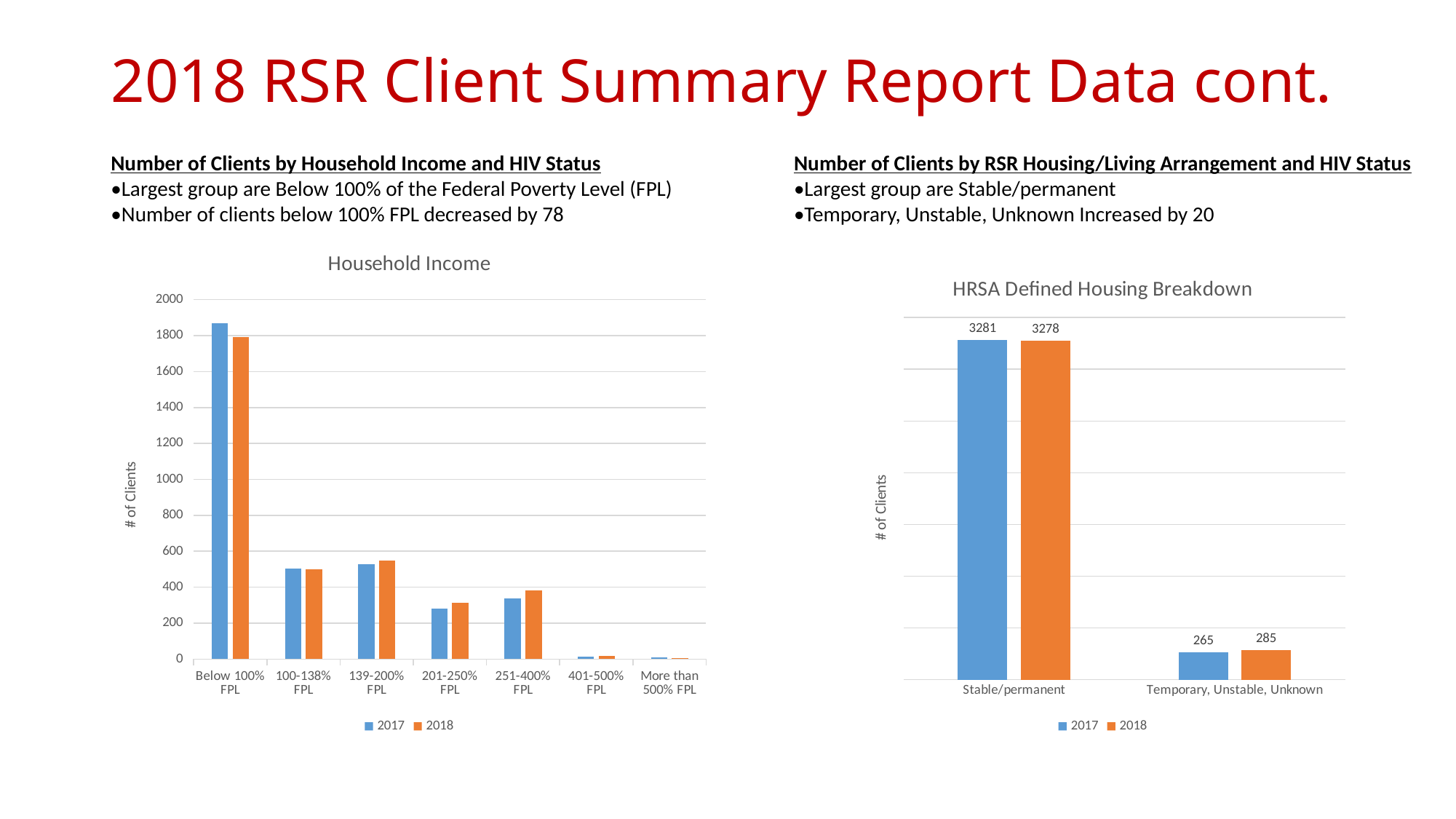
In the HRSA Defined Housing Breakdown chart, what is the difference between the 2017 and 2018 values for Stable/permanent? 3 How many series does the legend of the Household Income chart list? 2 In the HRSA Defined Housing Breakdown chart, what is the 2017 value for Temporary, Unstable, Unknown? 265 In the HRSA Defined Housing Breakdown chart, what is the 2018 value for Temporary, Unstable, Unknown? 285 In the Household Income chart, is the 2017 value for 201-250% FPL greater or less than 400? less In the HRSA Defined Housing Breakdown chart, what is the difference between the 2018 and 2017 values for Temporary, Unstable, Unknown? 20 In the Household Income chart, is the 2017 value for Below 100% FPL greater or less than 1800? greater In the Household Income chart, for 251-400% FPL, which year has the larger value, 2017 or 2018? 2018 In the HRSA Defined Housing Breakdown chart, what is the 2017 value for Stable/permanent? 3281 In the HRSA Defined Housing Breakdown chart, how many categories are shown on the x axis? 2 In the Household Income chart, which category has the highest number of clients? Below 100% FPL In the Household Income chart, how many categories are shown on the x axis? 7